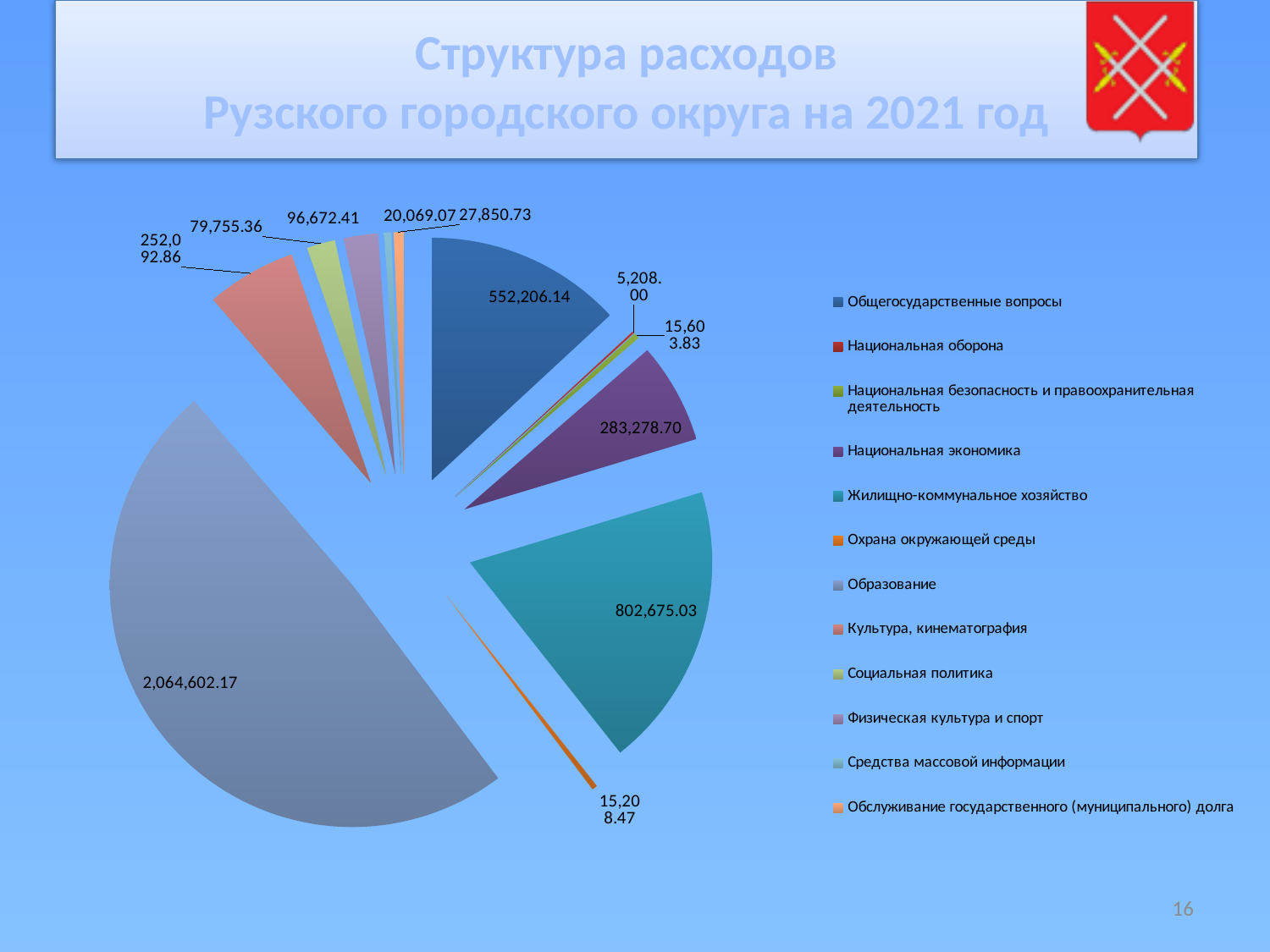
Which category has the largest slice? Образование What is the value for Физическая культура и спорт? 96,672.41 What is the value for Жилищно-коммунальное хозяйство? 802,675.03 What is the value for Национальная экономика? 283,278.70 How many categories (slices) does the pie chart have? 12 What is the title of the chart slide? Структура расходов Рузского городского округа на 2021 год What is the value for Общегосударственные вопросы? 552,206.14 Which is larger: Культура, кинематография or Социальная политика? Культура, кинематография Which category has the smallest slice? Национальная оборона What is the difference between the values for Жилищно-коммунальное хозяйство and Общегосударственные вопросы? 250,468.89 What kind of chart is shown on the slide? Pie chart What is the value for Образование? 2,064,602.17